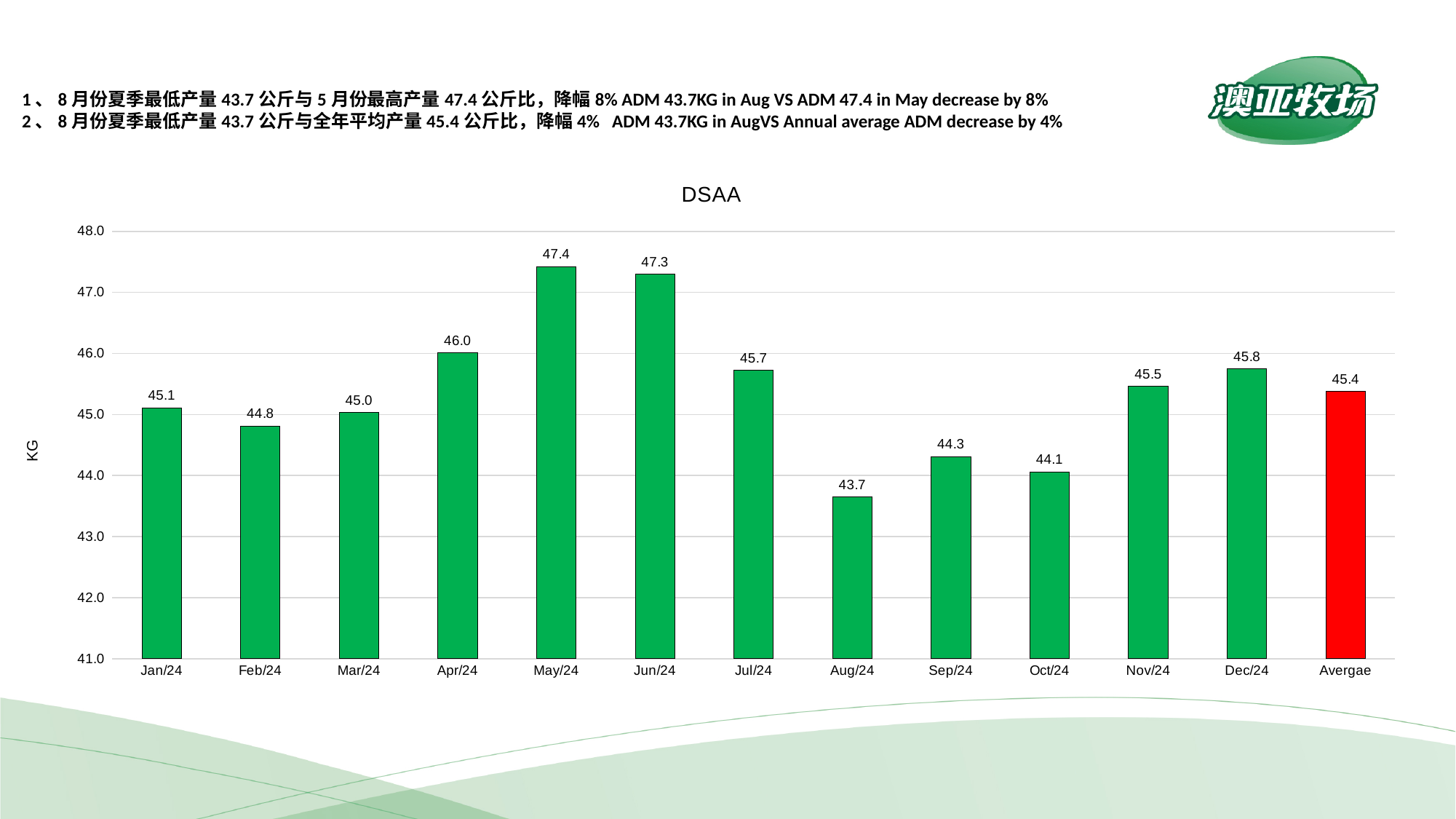
Is the value for Oct/24 in the DSAA chart greater or less than 45.0? less What is the difference between the May/24 and Aug/24 values in the DSAA chart? 3.7 What is the label on the vertical axis of the DSAA chart? KG What is the value for May/24 in the DSAA chart? 47.4 What kind of chart is the DSAA chart? bar chart What is the value for Aug/24 in the DSAA chart? 43.7 How many bars are plotted in the DSAA chart? 13 Which bar in the DSAA chart is coloured red instead of green? Avergae Which is larger in the DSAA chart, the value for Apr/24 or the value for Jul/24? Apr/24 Which month has the lowest value in the DSAA chart? Aug/24 Which month has the highest value in the DSAA chart? May/24 What is the value of the Avergae bar in the DSAA chart? 45.4